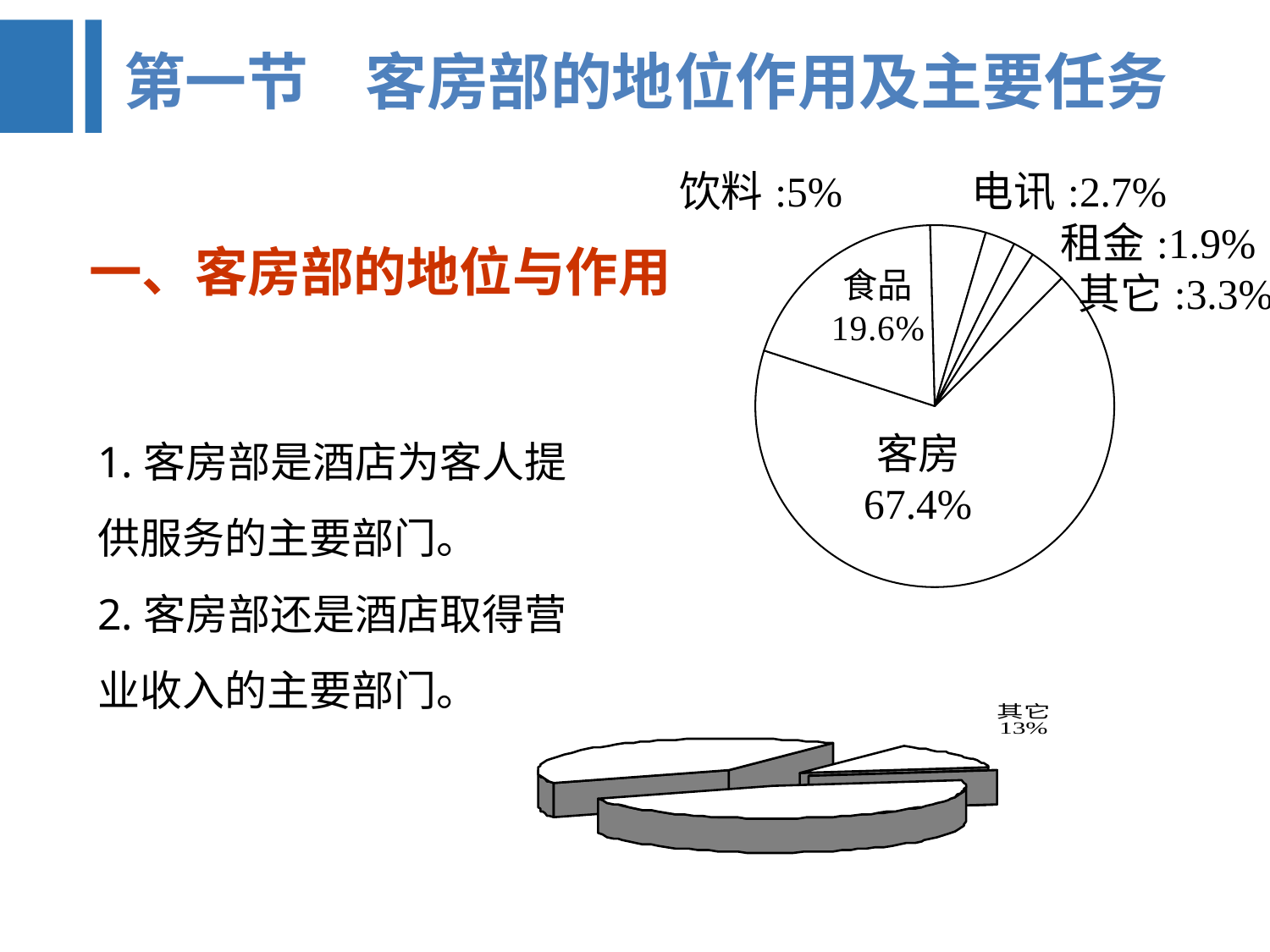
In the top pie chart, which category has the smallest share? 租金 In the top pie chart, what is the difference between the shares of 客房 and 食品? 47.8% In the top pie chart, what share does 客房 have? 67.4% In the bottom chart, what share is labelled for 其它? 13% In the top pie chart, which is larger, the share of 饮料 or the share of 其它? 饮料 In the top pie chart, what share does 租金 have? 1.9% In the top pie chart, what share does 其它 have? 3.3% In the top pie chart, what share does 饮料 have? 5% In the top pie chart, how many categories are shown? 6 In the top pie chart, what share does 电讯 have? 2.7% In the top pie chart, which category has the largest share? 客房 In the top pie chart, what share does 食品 have? 19.6%